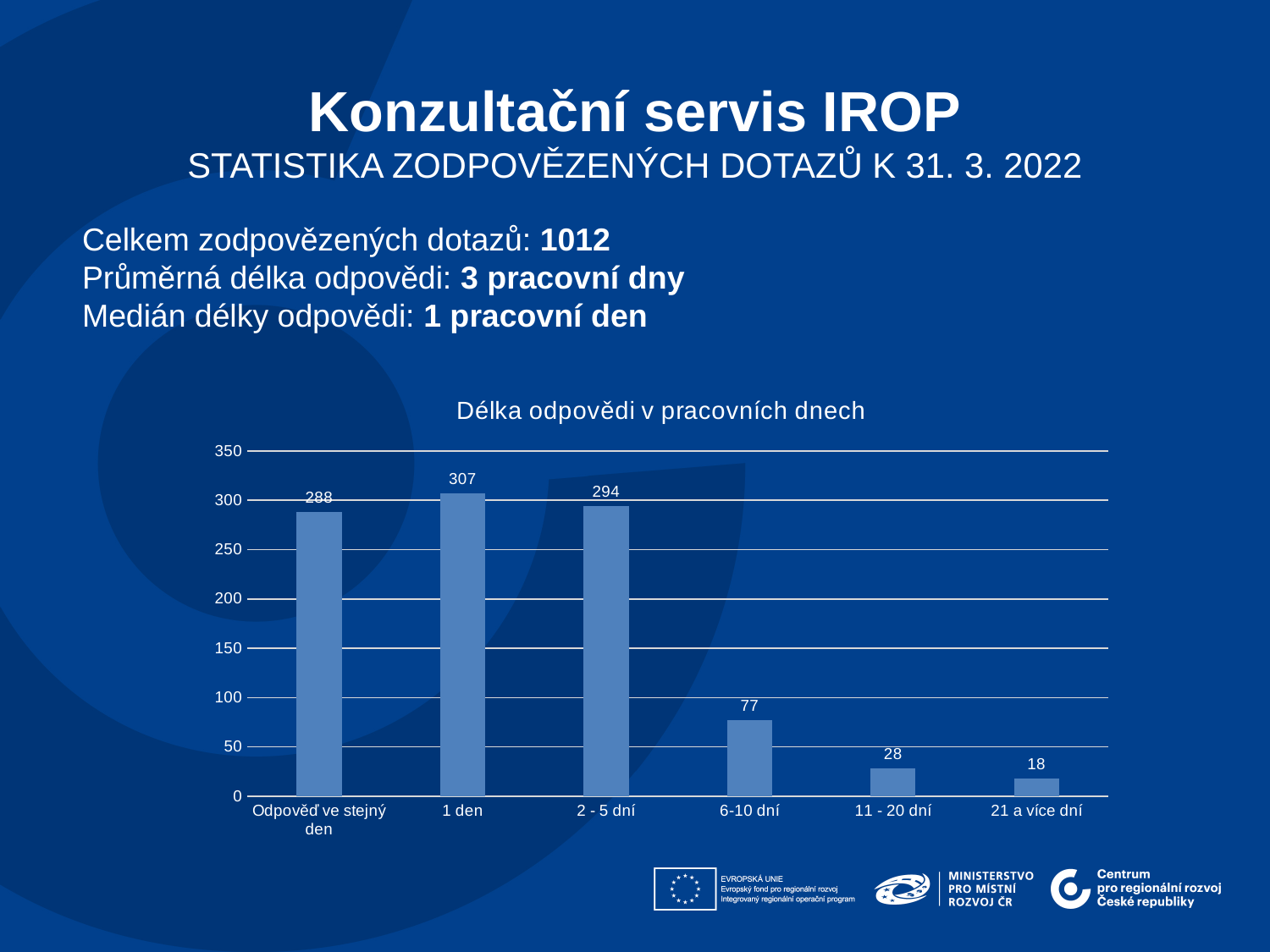
Which is larger, the value for 'Odpověď ve stejný den' or the value for '2 - 5 dní'? 2 - 5 dní What is the difference between the values for '6-10 dní' and '11 - 20 dní'? 49 What is the value for '6-10 dní'? 77 How many categories are shown on the x axis? 6 What is the title of the chart? Délka odpovědi v pracovních dnech What kind of chart is shown? bar chart What is the value for '21 a více dní'? 18 Which category has the lowest value? 21 a více dní Is the value for '11 - 20 dní' greater or less than 50? less What is the difference between the values for '1 den' and '2 - 5 dní'? 13 What is the value for '1 den'? 307 Which category has the highest value? 1 den